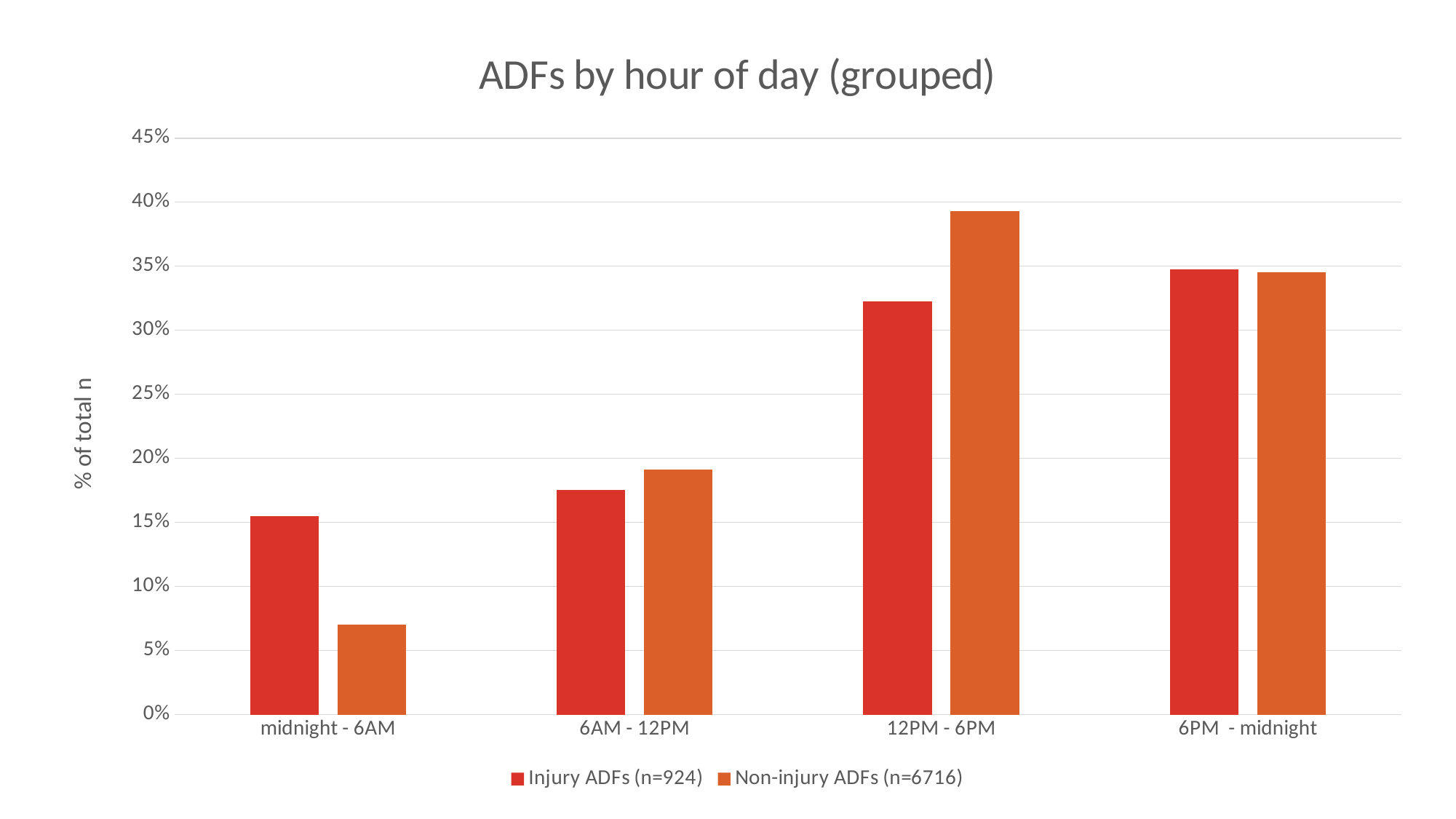
What is the title of the chart? ADFs by hour of day (grouped) Which time-of-day category has the lowest value for Non-injury ADFs (n=6716)? midnight - 6AM Which time-of-day category has the highest value for Non-injury ADFs (n=6716)? 12PM - 6PM What kind of chart is shown on the slide? bar chart For 12PM - 6PM, which series has the larger value, Injury ADFs (n=924) or Non-injury ADFs (n=6716)? Non-injury ADFs (n=6716) Is the value for Injury ADFs (n=924) at 12PM - 6PM greater or less than 30%? greater Which time-of-day category has the lowest value for Injury ADFs (n=924)? midnight - 6AM For midnight - 6AM, which series has the larger value, Injury ADFs (n=924) or Non-injury ADFs (n=6716)? Injury ADFs (n=924) How many series does the legend list? 2 How many time-of-day categories are shown on the x axis? 4 Is the value for Non-injury ADFs (n=6716) at 12PM - 6PM greater or less than 40%? less Is the value for Non-injury ADFs (n=6716) at midnight - 6AM greater or less than 10%? less